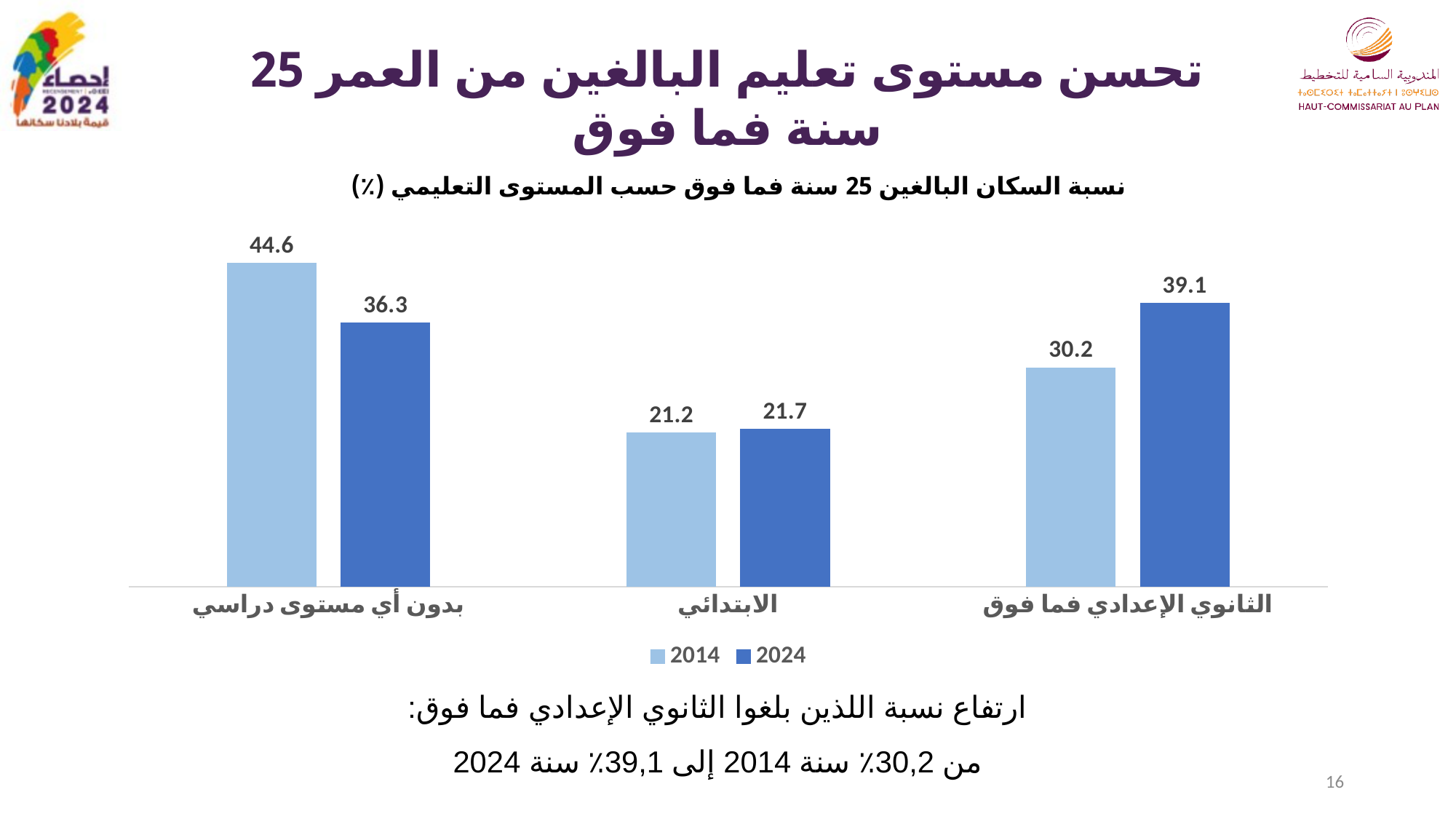
What is the difference between the 2024 and 2014 values for "الثانوي الإعدادي فما فوق"? 8.9 Which category has the highest value for the 2014 series? بدون أي مستوى دراسي What is the value for 2014 in the category "بدون أي مستوى دراسي"? 44.6 How many series does the legend list? 2 How many categories are shown on the x axis of the chart? 3 Which series is shown in the darker blue colour in the legend? 2024 What is the difference between the 2014 and 2024 values for "بدون أي مستوى دراسي"? 8.3 What is the value for 2024 in the category "الابتدائي"? 21.7 For "الثانوي الإعدادي فما فوق", which series has the larger value, 2014 or 2024? 2024 Which category has the lowest value for the 2024 series? الابتدائي What kind of chart is shown on the slide? bar chart What is the value for 2024 in the category "الثانوي الإعدادي فما فوق"? 39.1